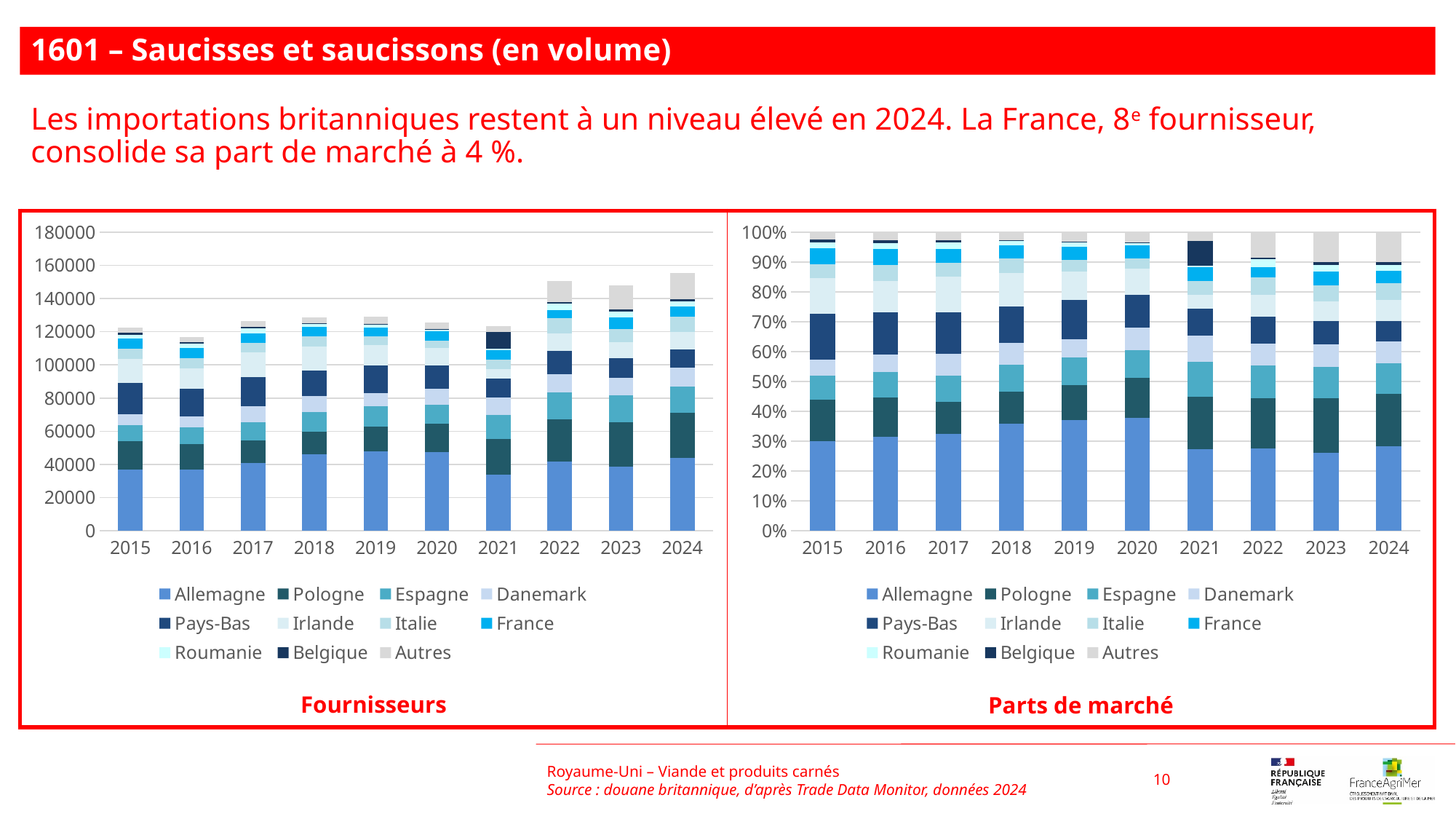
In the 'Fournisseurs' chart, which total bar is larger, 2016 or 2024? 2024 How many series does the legend of the 'Fournisseurs' chart list? 11 What kind of chart is the 'Fournisseurs' chart on the left? Stacked bar chart In the 'Parts de marché' chart, is the share for Allemagne in 2023 greater or less than 30%? less In the 'Parts de marché' chart, is the share for Allemagne in 2020 greater or less than 30%? greater How many years are shown on the x axis of the 'Parts de marché' chart? 10 In the 'Fournisseurs' chart, which year has the lowest total bar? 2016 In the 'Parts de marché' chart, which year has the larger Allemagne share, 2020 or 2023? 2020 In the 'Fournisseurs' chart, is the total for 2021 greater or less than 140000? less What is the title shown under the left chart? Fournisseurs